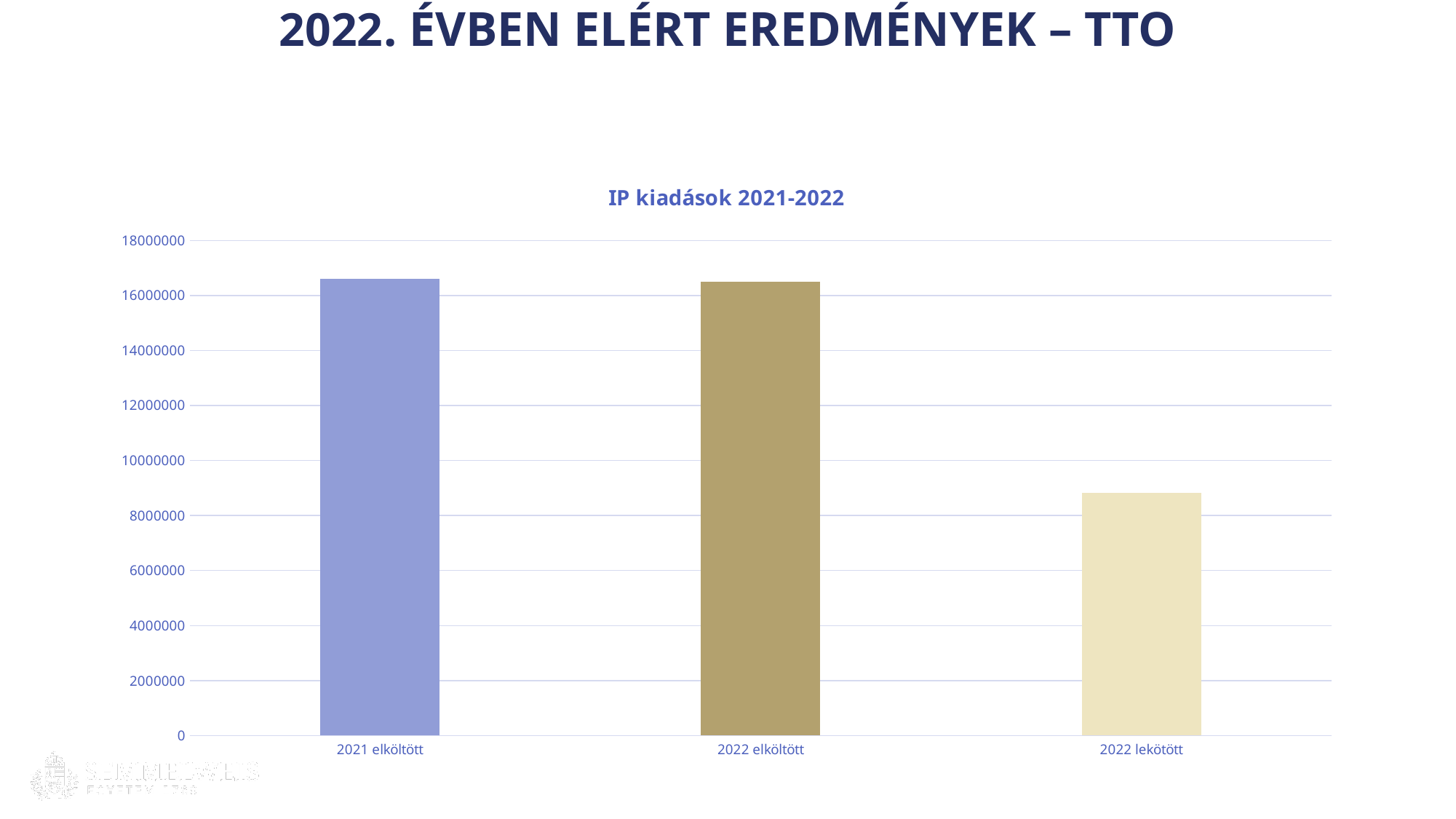
Which is larger, the value for 2022 elköltött or the value for 2022 lekötött? 2022 elköltött Is the value for 2021 elköltött greater or less than 16000000? greater How many bars does the chart show? 3 What kind of chart is shown on the slide? bar chart Is the value for 2022 elköltött greater or less than 16000000? greater Do the values rise or fall from left to right across the categories? fall What is the highest value shown on the vertical axis? 18000000 What is the title of the chart? IP kiadások 2021-2022 Is the value for 2022 lekötött greater or less than 8000000? greater Which is larger, the value for 2021 elköltött or the value for 2022 lekötött? 2021 elköltött Which category has the lowest value? 2022 lekötött